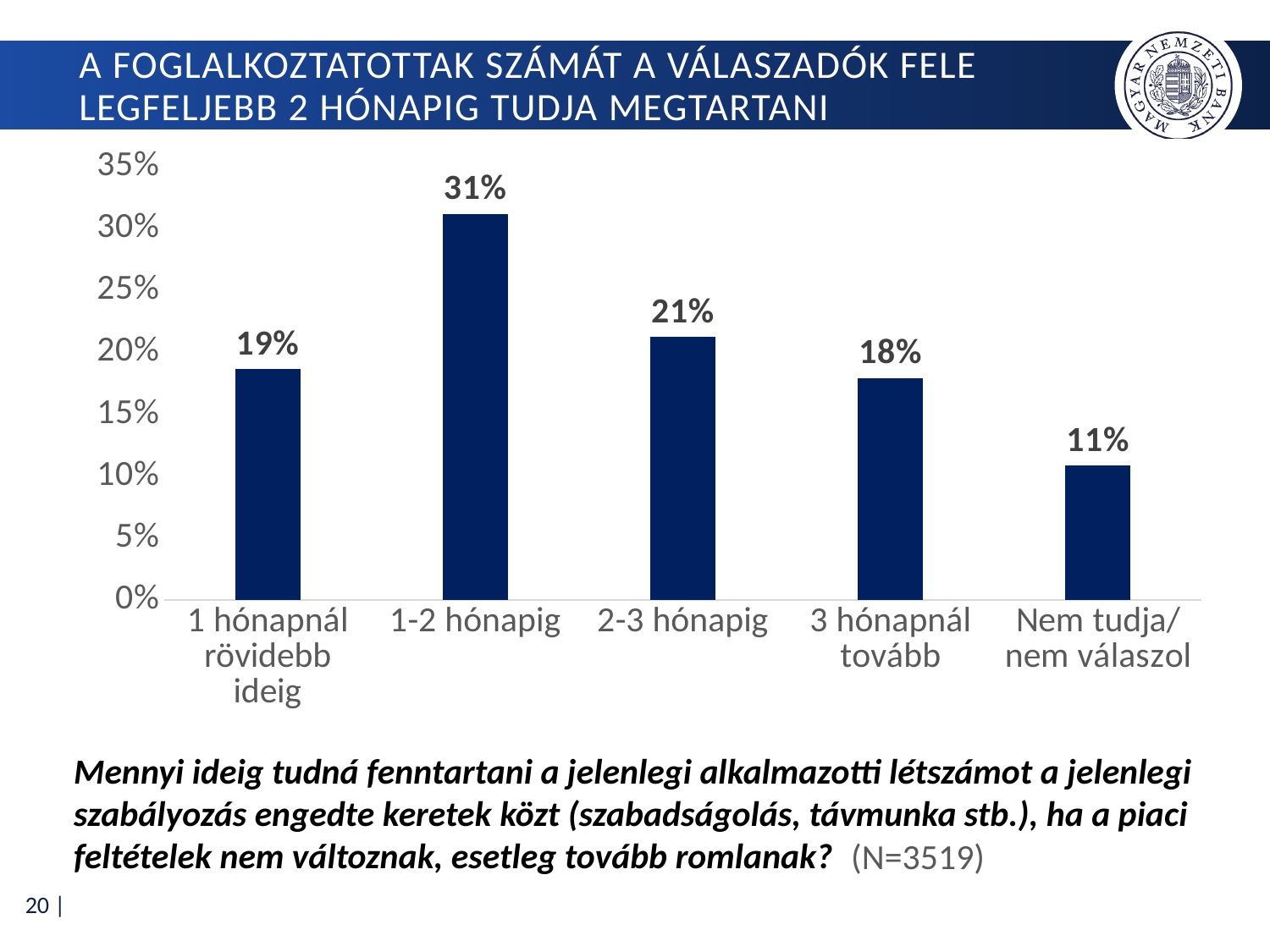
What kind of chart is shown on the slide? bar chart Is the value for "1-2 hónapig" greater or less than 25%? greater What is the sample size (N) stated below the chart? N=3519 What is the value for "Nem tudja/ nem válaszol"? 11% What is the difference between the values for "1-2 hónapig" and "2-3 hónapig"? 10% What is the value for "3 hónapnál tovább"? 18% What is the value for "1-2 hónapig"? 31% How many categories are shown on the x axis? 5 What is the difference between the values for "1 hónapnál rövidebb ideig" and "Nem tudja/ nem válaszol"? 8% Which is larger, the value for "2-3 hónapig" or the value for "3 hónapnál tovább"? 2-3 hónapig Which category has the lowest value? Nem tudja/ nem válaszol Which category has the highest value? 1-2 hónapig